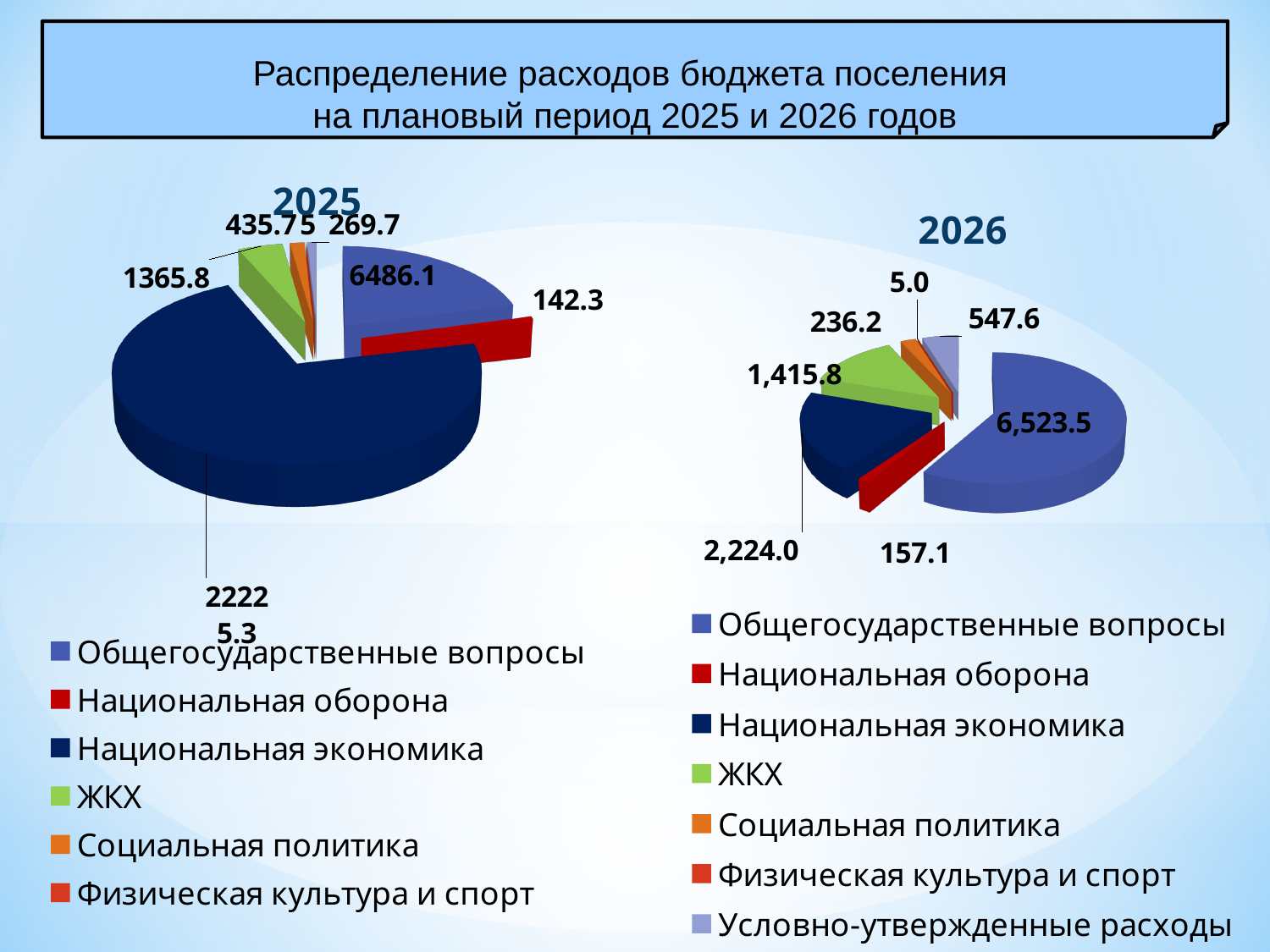
In the 2026 chart, what is the difference between Общегосударственные вопросы and Национальная экономика? 4,299.5 What type of charts are shown on the slide? Pie charts In the 2025 chart, which category has the largest slice? Национальная экономика In the 2025 chart, what is the value for Общегосударственные вопросы? 6486.1 In the 2026 chart, what is the value for Общегосударственные вопросы? 6,523.5 In the 2026 chart, what is the value for ЖКХ? 1,415.8 In the 2026 chart, what is the value for Условно-утвержденные расходы? 547.6 How many categories does the legend of the 2026 chart list? 7 In the 2026 chart, which is larger: ЖКХ or Социальная политика? ЖКХ In the 2026 chart, which category has the largest slice? Общегосударственные вопросы In the 2026 chart, what is the value for Национальная оборона? 157.1 In the 2026 chart, which category has the smallest value? Физическая культура и спорт